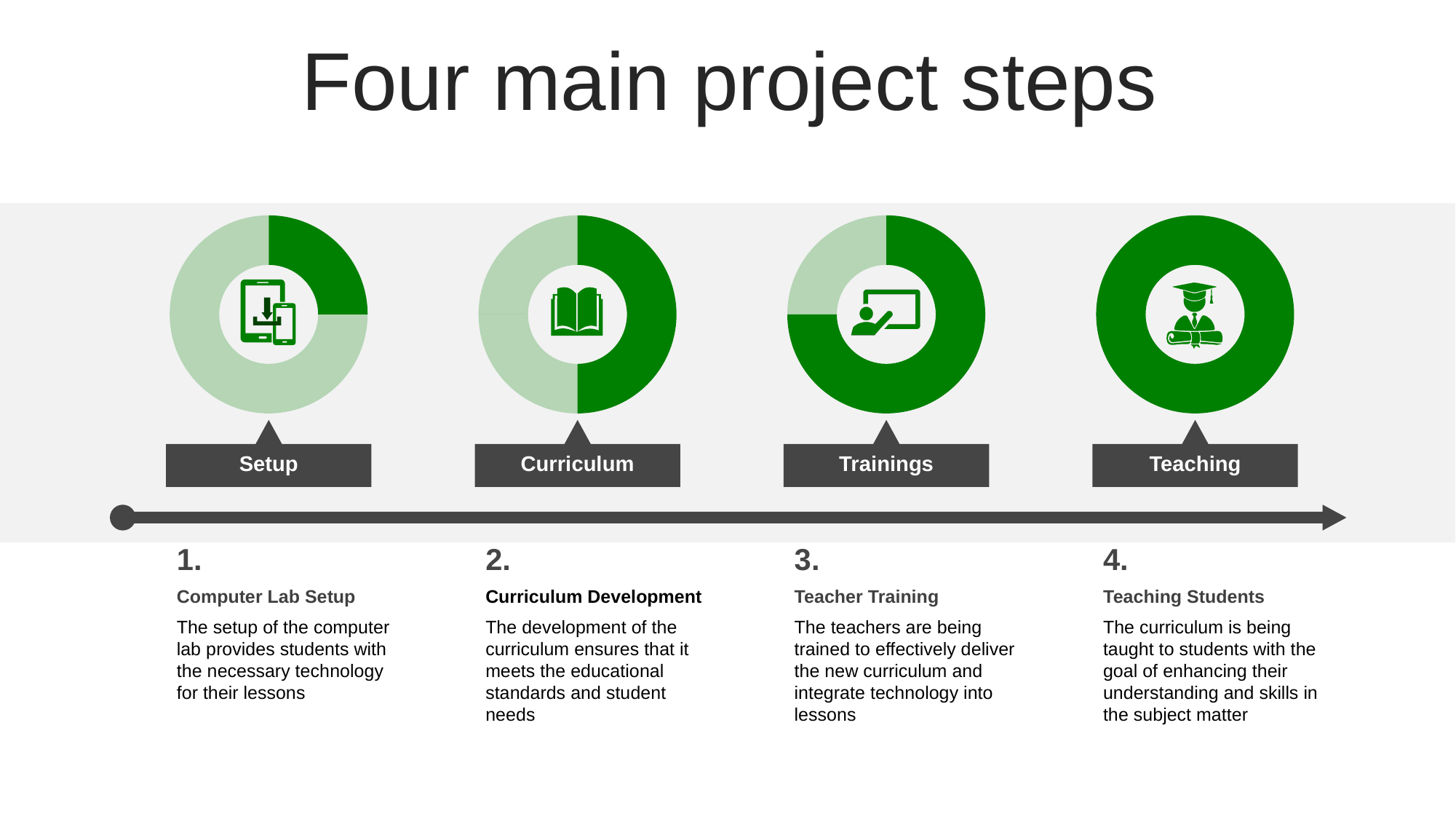
Which donut chart has a larger dark green filled portion, Curriculum or Trainings? Trainings Which step's donut chart has the largest dark green filled portion? Teaching Which donut chart is completely filled with dark green? Teaching Which donut chart has a larger dark green filled portion, Setup or Curriculum? Curriculum How many donut charts are shown on the slide? 4 What is the title of the slide containing the four donut charts? Four main project steps Which step's donut chart has the smallest dark green filled portion? Setup What kind of chart is used for each of the four project steps on the slide? Donut chart Does the dark green filled portion of the donut charts increase or decrease from left to right across the slide? Increase What is the label shown beneath the third donut chart? Trainings